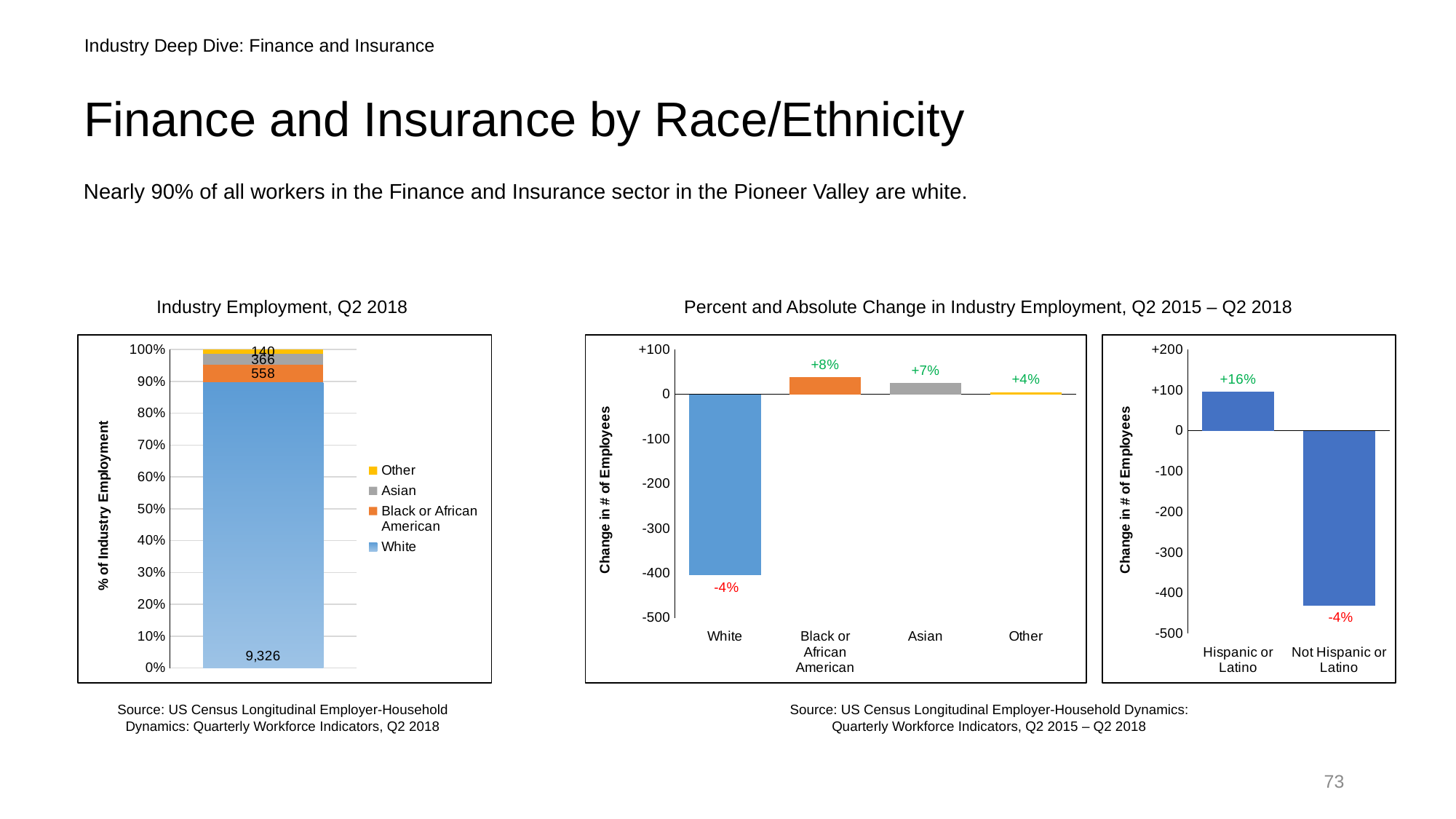
In the 'Industry Employment, Q2 2018' chart, what is the value labelled for Asian? 366 In the 'Industry Employment, Q2 2018' chart, what is the value labelled for White? 9,326 In the middle chart (Percent and Absolute Change by race), is the change in number of employees for Black or African American greater or less than 100? less In the right-hand chart (Hispanic or Latino vs Not Hispanic or Latino), is the change in number of employees for Not Hispanic or Latino greater or less than -400? less In the 'Industry Employment, Q2 2018' chart, which group has the smallest labelled value? Other In the middle chart (Percent and Absolute Change by race), which group shows a negative percent change? White In the 'Industry Employment, Q2 2018' chart, what is the value labelled for Black or African American? 558 In the middle chart (Percent and Absolute Change by race), what percent change is labelled for Black or African American? +8% In the 'Industry Employment, Q2 2018' chart, what is the difference between the White value and the Black or African American value? 8,768 In the 'Industry Employment, Q2 2018' chart, what is the total of all four labelled segments in the stacked bar? 10,390 How many series does the legend of the 'Industry Employment, Q2 2018' chart list? 4 In the right-hand chart (Hispanic or Latino vs Not Hispanic or Latino), what percent change is labelled for Hispanic or Latino? +16%